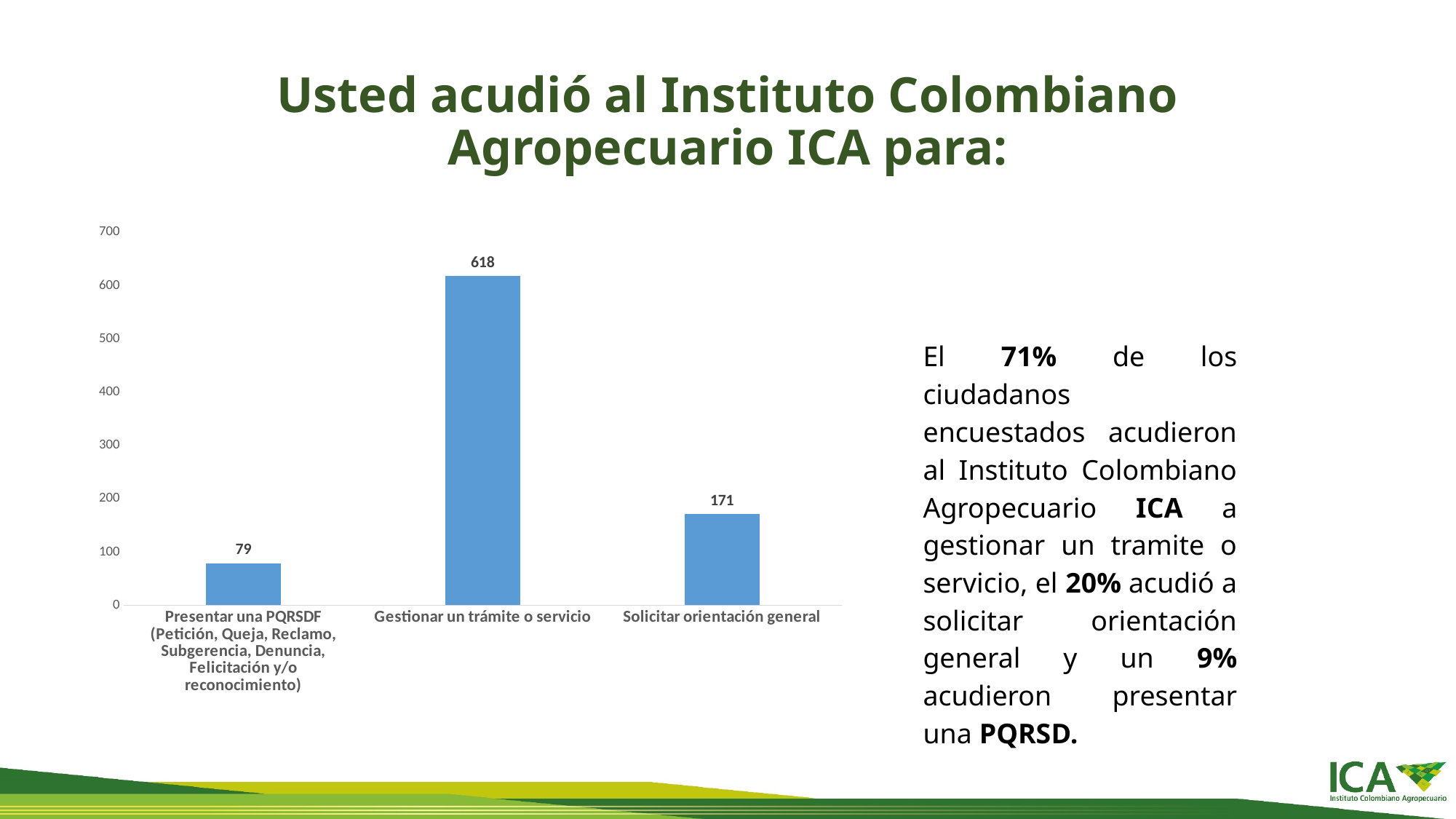
What kind of chart is shown on the slide? Bar chart What is the value for "Gestionar un trámite o servicio"? 618 Which category has the highest value? Gestionar un trámite o servicio How many categories are shown on the chart? 3 What is the total of the three values shown on the chart? 868 What is the value for "Presentar una PQRSDF"? 79 What is the value for "Solicitar orientación general"? 171 What is the difference between the values for "Solicitar orientación general" and "Presentar una PQRSDF"? 92 What is the difference between the values for "Gestionar un trámite o servicio" and "Solicitar orientación general"? 447 Which is larger, the value for "Solicitar orientación general" or the value for "Presentar una PQRSDF"? Solicitar orientación general Which category has the lowest value? Presentar una PQRSDF Is the value for "Gestionar un trámite o servicio" greater or less than 600? greater